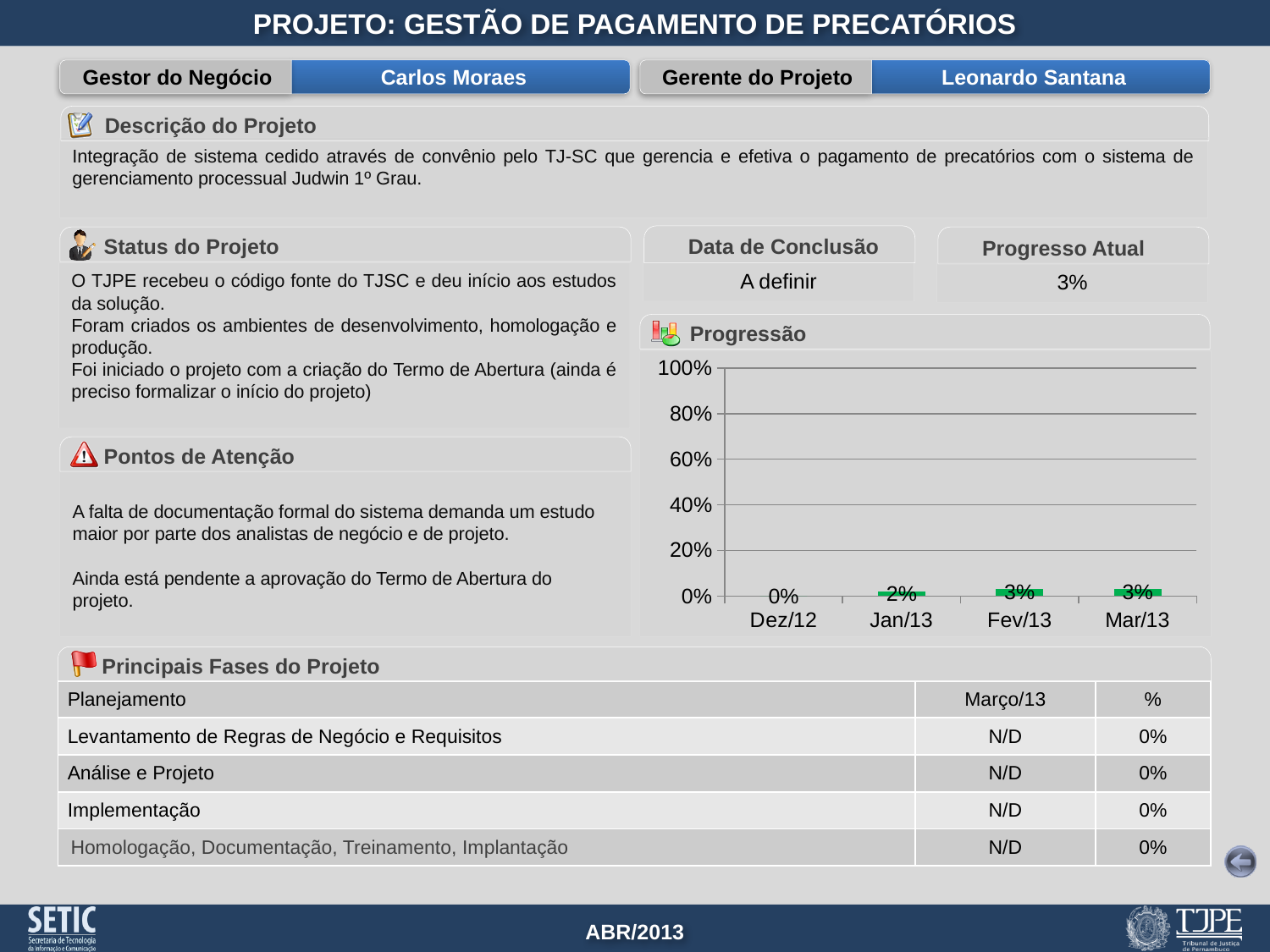
Which month has the lowest value in the Progressão chart? Dez/12 What is the difference between the values for Mar/13 and Dez/12 in the Progressão chart? 3% What is the value for Fev/13 in the Progressão chart? 3% How many months are plotted in the Progressão chart? 4 What kind of chart is the Progressão chart? bar chart Is the value for Mar/13 in the Progressão chart greater or less than 20%? less In the Progressão chart, which is larger, the value for Jan/13 or the value for Dez/12? Jan/13 What is the value for Dez/12 in the Progressão chart? 0% Do the values in the Progressão chart rise or fall from Dez/12 to Fev/13? rise What is the value for Jan/13 in the Progressão chart? 2% What is the value for Mar/13 in the Progressão chart? 3% What is the difference between the values for Fev/13 and Jan/13 in the Progressão chart? 1%